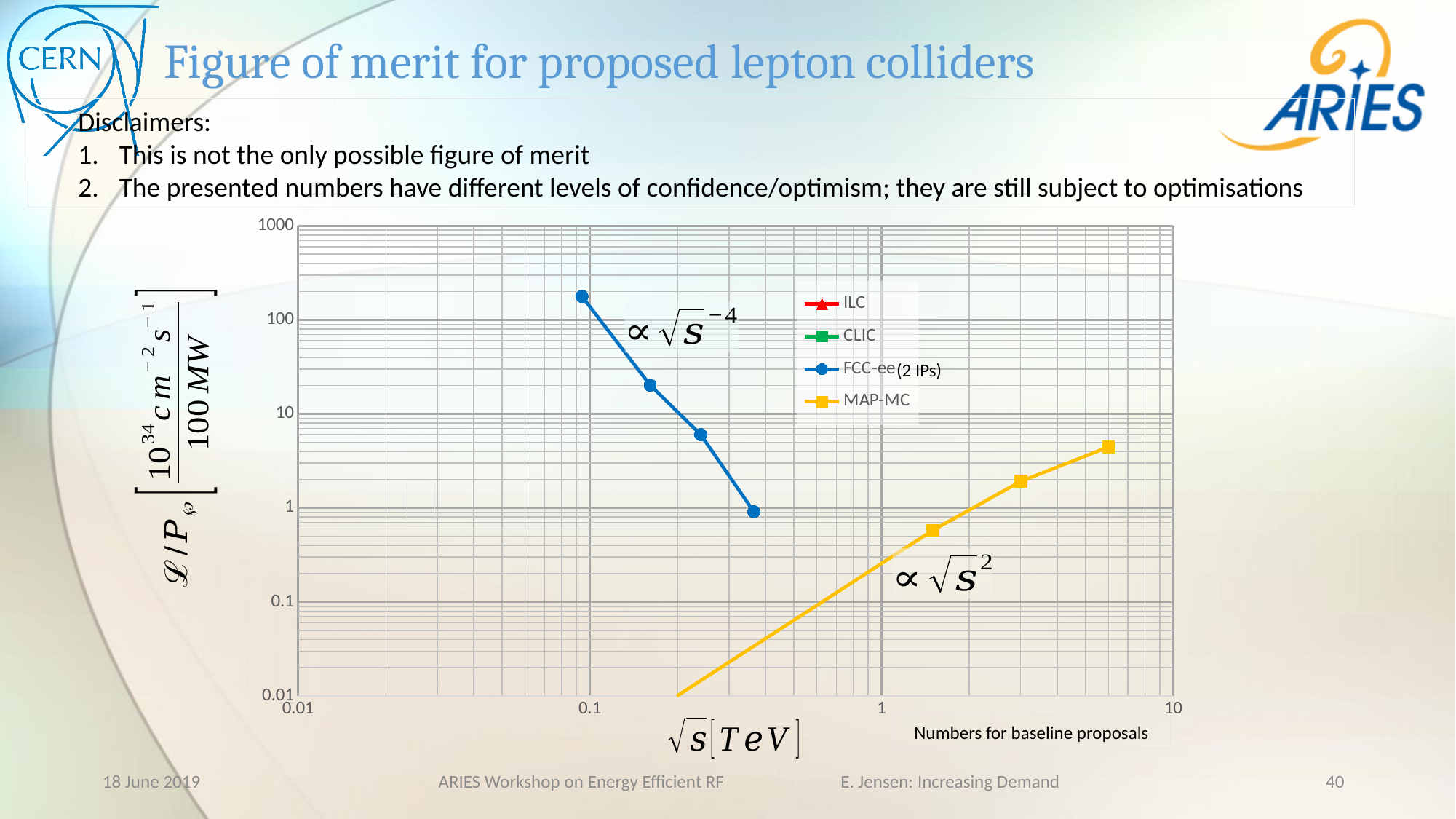
Which series are listed in the legend? ILC, CLIC, FCC-ee (2 IPs), MAP-MC Does the MAP-MC series rise or fall as √s increases? rise Does the FCC-ee (2 IPs) series rise or fall as √s increases? fall Is the highest FCC-ee (2 IPs) value greater or less than 100? greater How many data points are plotted for the FCC-ee (2 IPs) series? 4 Is the highest MAP-MC value greater or less than 10? less How many series does the legend list? 4 What is the label of the x axis? √s [TeV] Which series reaches the higher maximum value, FCC-ee (2 IPs) or MAP-MC? FCC-ee (2 IPs) How many data points are plotted for the MAP-MC series? 3 Is the lowest MAP-MC data point greater or less than 1? less What kind of chart is shown on the slide? line chart